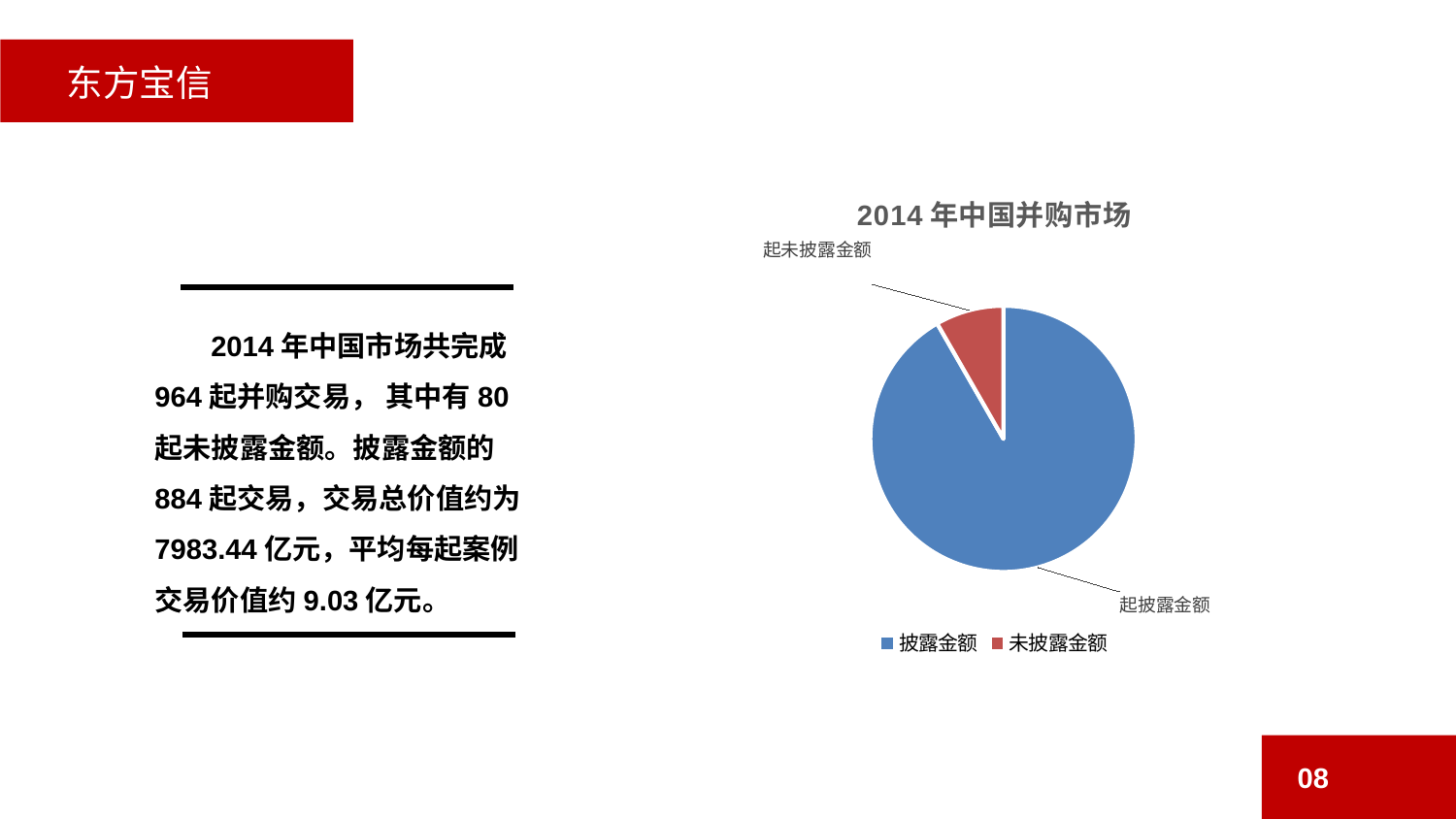
Which slice of the pie chart is the largest? 披露金额 How many entries does the legend of the pie chart list? 2 What is the title of the pie chart? 2014 年中国并购市场 Which slice of the pie chart is the smallest? 未披露金额 In the pie chart, which is larger: 披露金额 or 未披露金额? 披露金额 What colour is the 未披露金额 slice in the pie chart? red What kind of chart is shown on the slide? pie chart How many slices does the pie chart have? 2